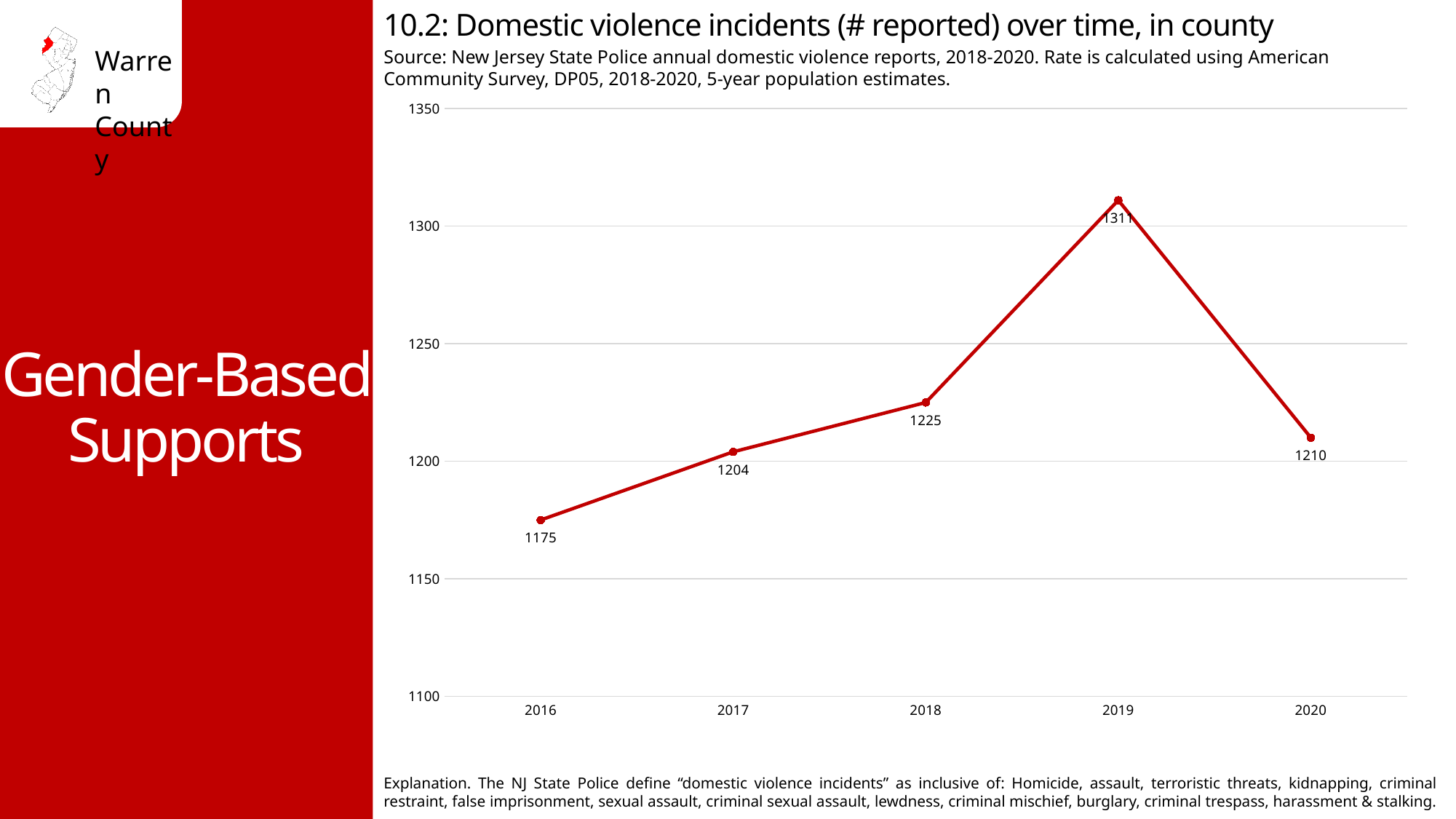
How many more incidents were reported in 2019 than in 2018? 86 Is the value for 2017 greater or less than 1200? greater What was the number of reported domestic violence incidents in 2020? 1210 Did the number of reported incidents rise or fall from 2016 to 2019? Rise How many years are plotted on the chart? 5 What was the number of reported domestic violence incidents in 2019? 1311 Which year had the highest number of reported domestic violence incidents? 2019 Which year had the lowest number of reported domestic violence incidents? 2016 What was the number of reported domestic violence incidents in 2016? 1175 Which year had more reported incidents, 2018 or 2020? 2018 What kind of chart is shown on the slide? Line chart What is the difference in reported incidents between 2017 and 2016? 29